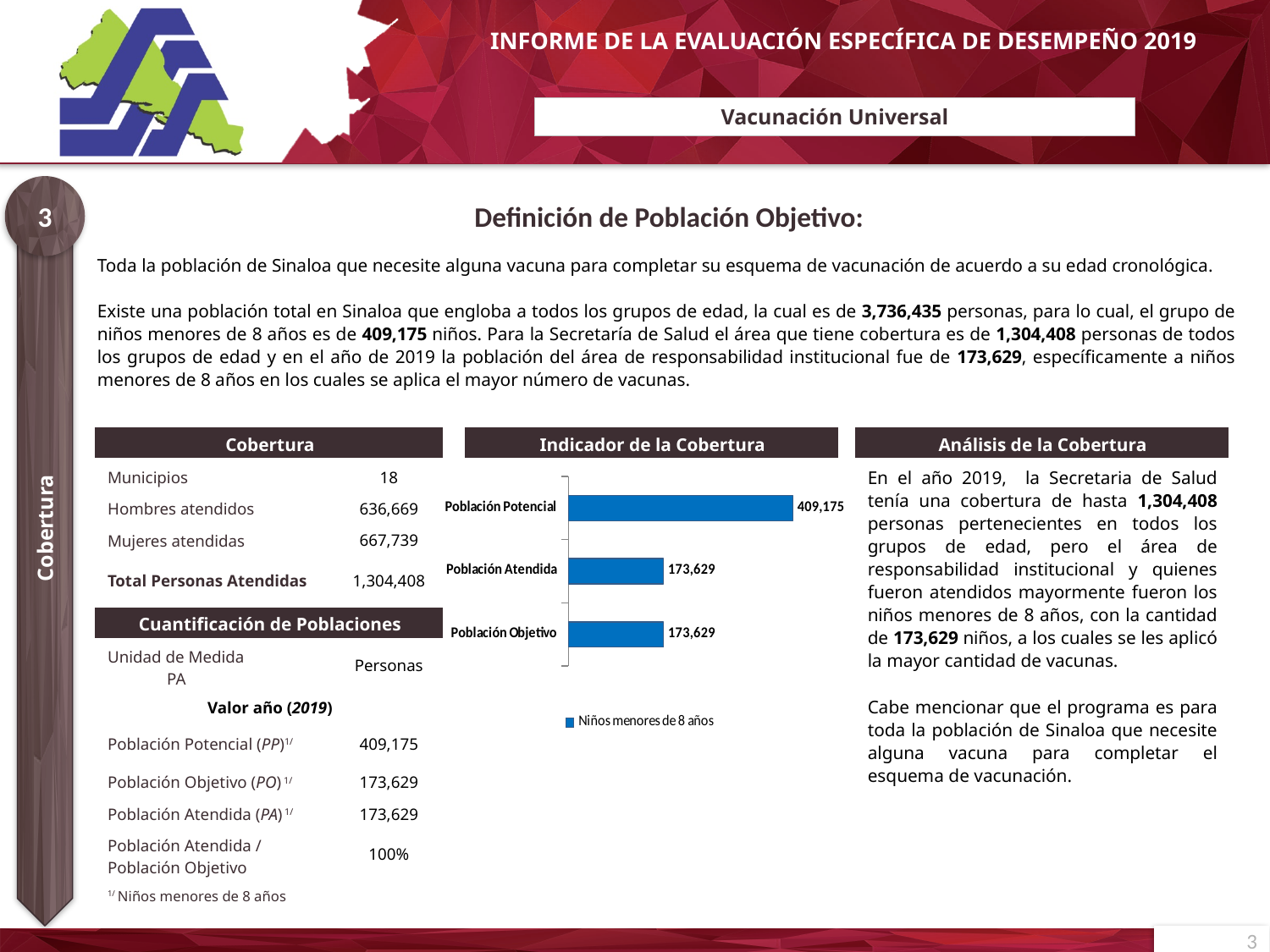
In the "Indicador de la Cobertura" chart, do Población Atendida and Población Objetivo have the same value? yes What colour are the bars in the "Indicador de la Cobertura" chart? blue In the "Indicador de la Cobertura" chart, what is the value for Población Potencial? 409,175 What type of chart is shown under "Indicador de la Cobertura"? bar chart What is the legend entry in the "Indicador de la Cobertura" chart? Niños menores de 8 años In the "Indicador de la Cobertura" chart, which category has the highest value? Población Potencial How many series does the legend of the "Indicador de la Cobertura" chart list? 1 In the "Indicador de la Cobertura" chart, what is the difference between Población Potencial and Población Objetivo? 235,546 In the "Indicador de la Cobertura" chart, what is the value for Población Objetivo? 173,629 How many categories are plotted in the "Indicador de la Cobertura" chart? 3 In the "Indicador de la Cobertura" chart, what is the value for Población Atendida? 173,629 In the "Indicador de la Cobertura" chart, which is larger, Población Potencial or Población Atendida? Población Potencial